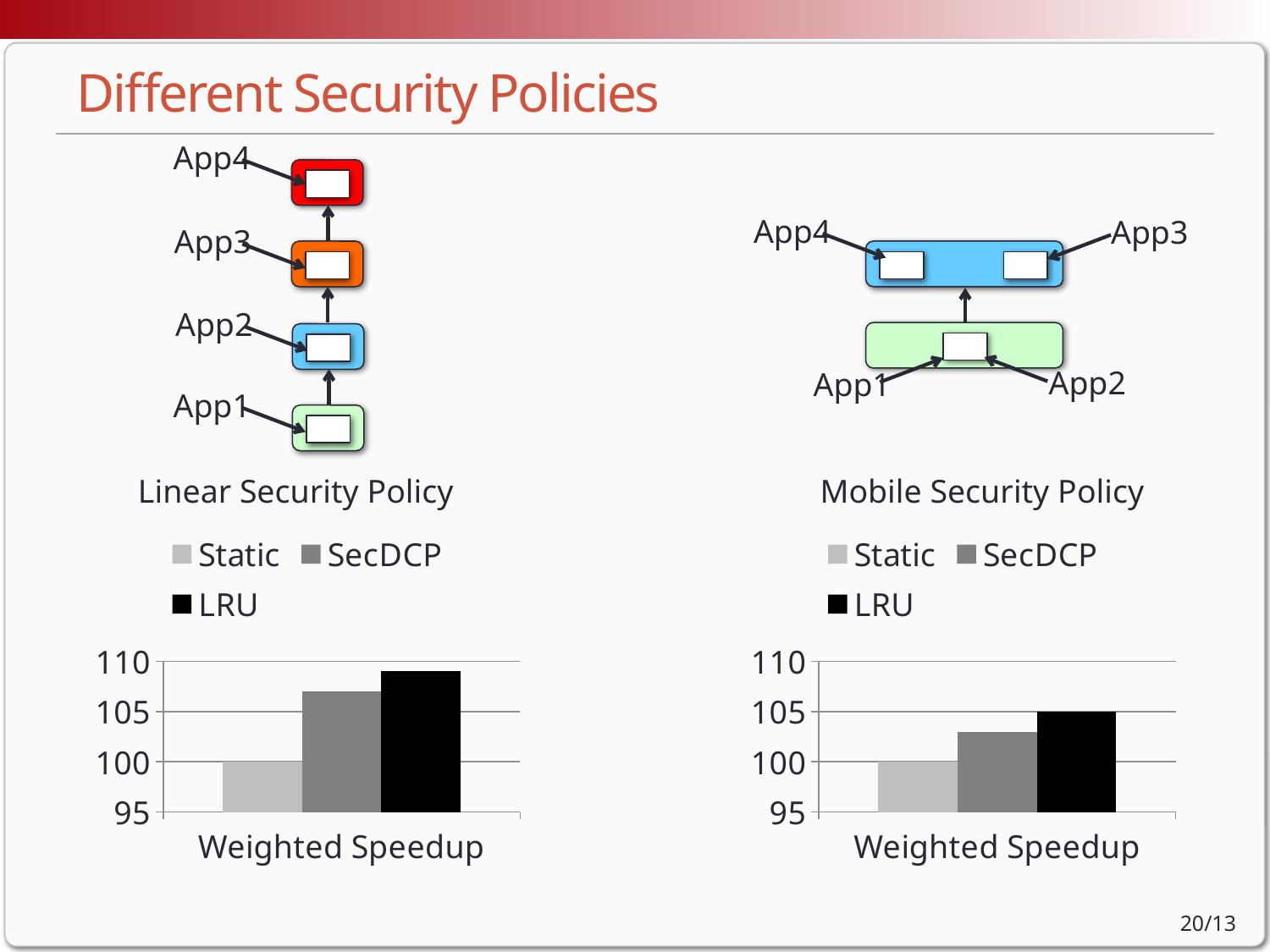
In the chart under Mobile Security Policy, what is the label on the x axis? Weighted Speedup In the chart under Linear Security Policy, which is larger, the value for SecDCP or the value for Static? SecDCP In the chart under Linear Security Policy, what is the Weighted Speedup value for Static? 100 In the chart under Mobile Security Policy, how many series does the legend list? 3 In the chart under Linear Security Policy, is the value for SecDCP greater or less than 105? greater In the chart under Linear Security Policy, what kind of chart is shown? bar chart In the chart under Mobile Security Policy, what is the Weighted Speedup value for LRU? 105 In the chart under Mobile Security Policy, is the value for SecDCP greater or less than 105? less In the chart under Mobile Security Policy, which series has the lowest Weighted Speedup? Static In the chart under Linear Security Policy, how many categories are shown on the x axis? 1 In the chart under Linear Security Policy, which series has the highest Weighted Speedup? LRU In the chart under Linear Security Policy, which series is drawn in black? LRU